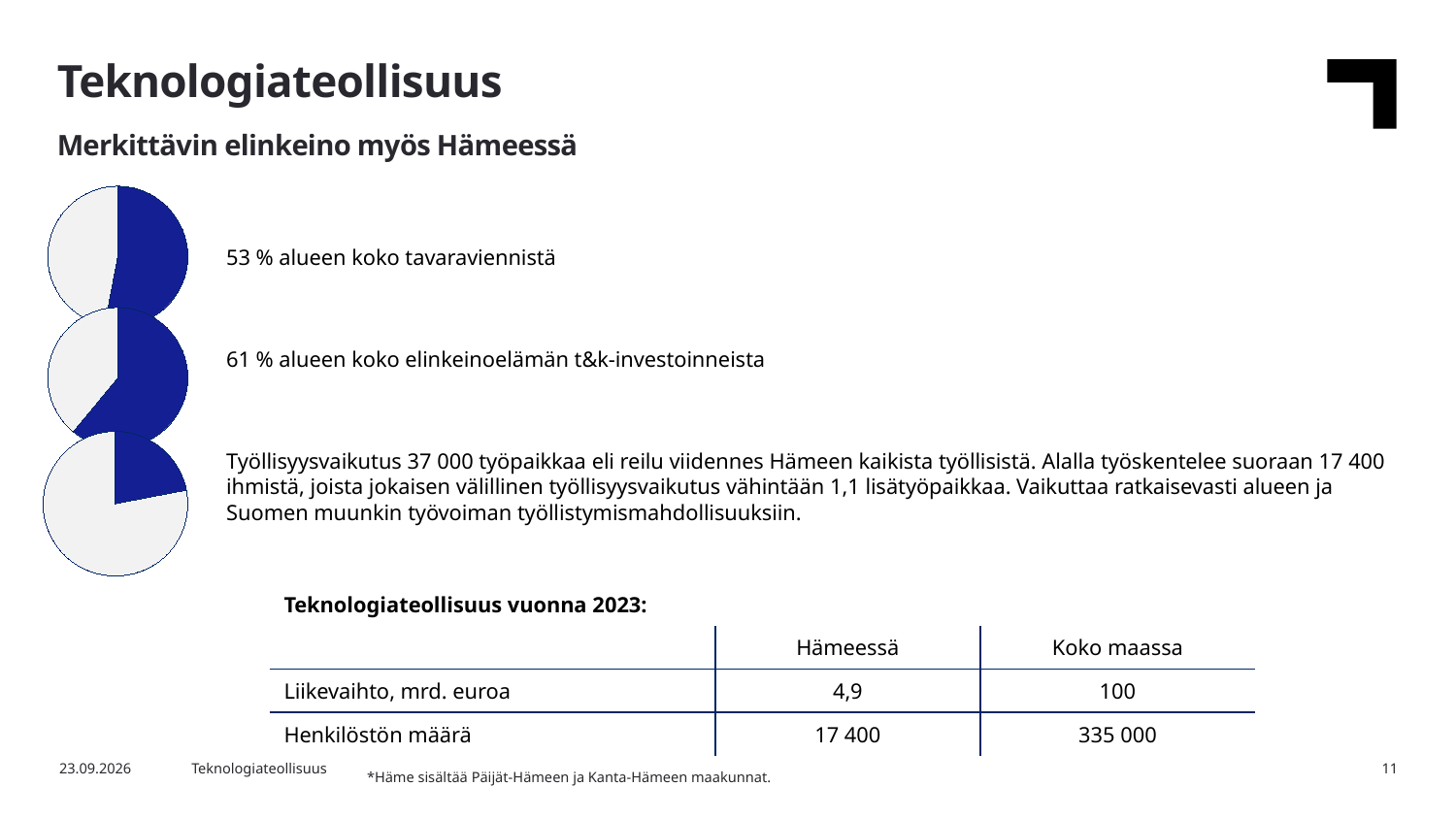
In the bottom pie chart, is the blue slice greater or less than half of the pie? less How many pie charts are on the slide? 3 What does the blue slice of the top pie chart represent? 53 % alueen koko tavaraviennistä In the middle pie chart, what share of the region's business R&D investments (elinkeinoelämän t&k-investoinneista) does the blue slice represent? 61 % Of the three pie charts, which one has the largest blue slice? The middle one (61 %) In the middle pie chart, is the blue slice greater or less than half of the pie? greater Of the three pie charts, which one has the smallest blue slice? The bottom one In the top pie chart, what share of the region's total goods exports (alueen koko tavaraviennistä) does the blue slice represent? 53 % Which pie chart has the larger blue slice, the top one (tavaravienti) or the middle one (t&k-investoinnit)? The middle one (61 %) Which pie chart has the larger blue slice, the top one or the bottom one? The top one What colour is the highlighted slice in each pie chart? Dark blue What kind of chart is shown at the top left of the slide? Pie chart